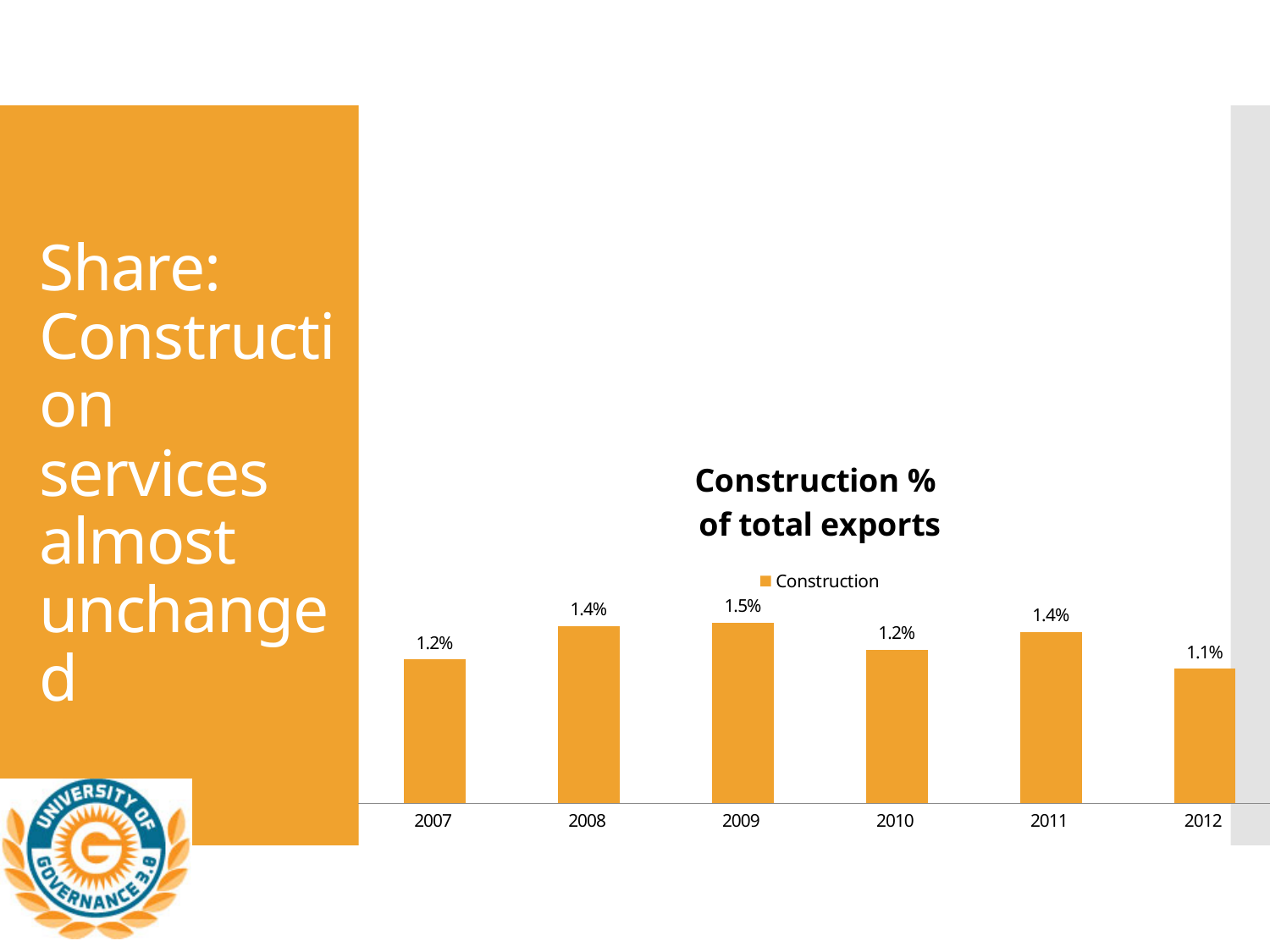
Does the Construction % of total exports rise or fall from 2011 to 2012? Fall How many series does the chart legend list? 1 Which year has a larger Construction % of total exports, 2008 or 2010? 2008 What is the difference between the Construction % of total exports in 2009 and in 2012? 0.4% What is the title of the chart? Construction % of total exports What is the Construction % of total exports in 2012? 1.1% What is the Construction % of total exports in 2009? 1.5% Which year has the highest Construction % of total exports? 2009 What kind of chart is shown on the slide? Bar chart Which year has the lowest Construction % of total exports? 2012 What is the Construction % of total exports in 2007? 1.2% How many years are shown on the x axis of the chart? 6